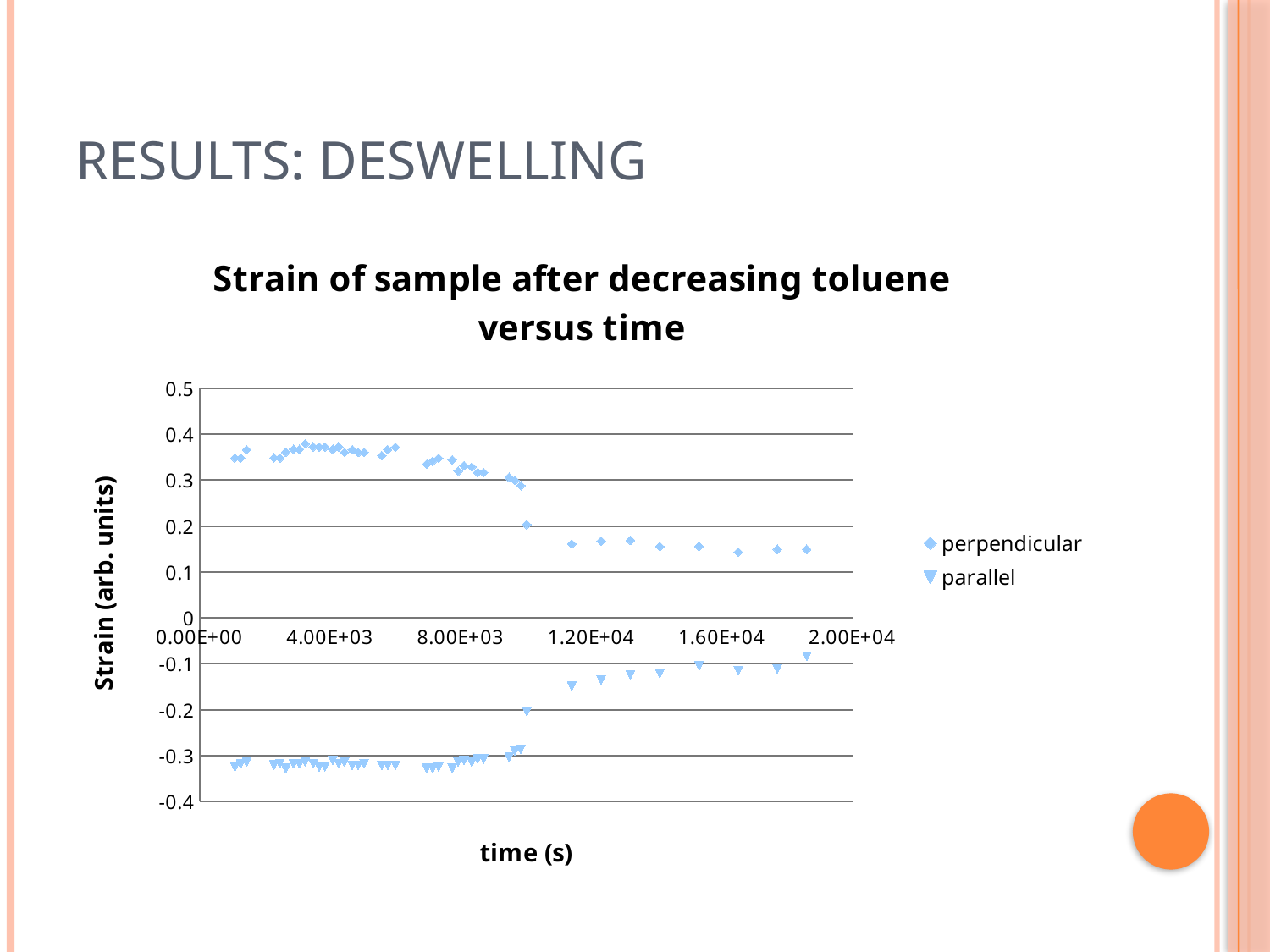
What are the two series named in the legend? perpendicular and parallel Which series has the lowest strain value on the chart? parallel Is the perpendicular strain near time 4.00E+03 greater or less than 0.3? greater At time 1.20E+04, which series has the larger strain value, perpendicular or parallel? perpendicular Is the parallel strain near time 1.60E+04 greater or less than -0.2? greater Is the parallel strain near time 4.00E+03 greater or less than -0.3? less What kind of chart is shown on the slide? scatter chart What is the title of the chart? Strain of sample after decreasing toluene versus time Do the perpendicular strain values rise or fall as time increases? fall Do the parallel strain values rise or fall as time increases? rise How many series does the legend list? 2